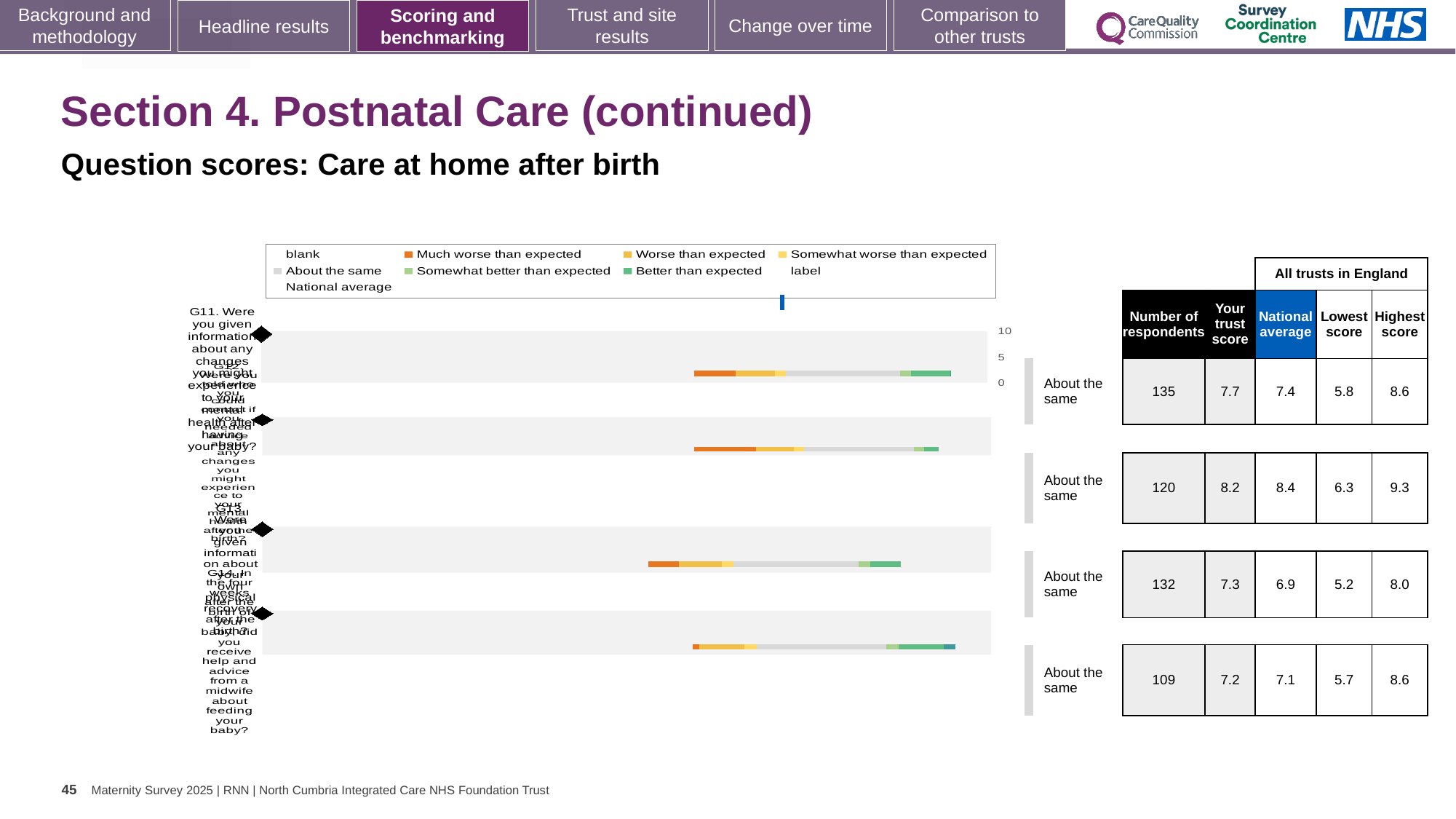
In the table beside the chart, what is the 'Number of respondents' in the bottom row? 109 How many horizontal bars are plotted in the chart? 4 In the table beside the chart, what is the difference between the 'Your trust score' and the 'National average' in the third row? 0.4 In the table beside the chart, what is the 'Your trust score' value in the top row? 7.7 What colour does the legend use for 'Much worse than expected'? orange In the table beside the chart, which row has the highest 'Highest score' value? the second row (9.3) What kind of chart is shown on the slide? bar chart What colour does the legend use for 'Better than expected'? green